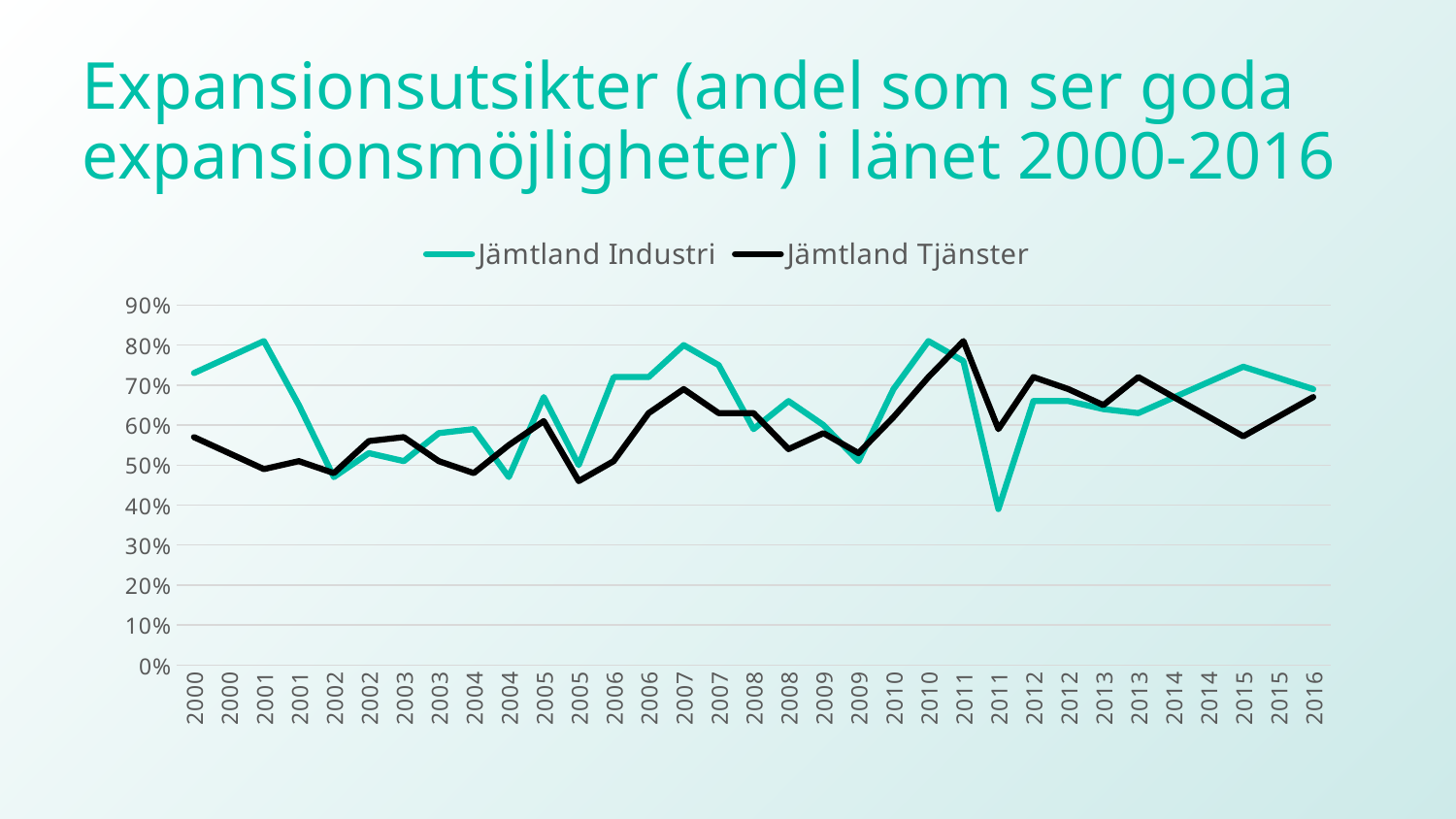
Which two series are listed in the legend? Jämtland Industri and Jämtland Tjänster Is the first 2000 value for Jämtland Industri greater or less than 70%? greater Is the first 2007 value for Jämtland Industri greater or less than 70%? greater What colour is the line for Jämtland Industri? Teal (green) What kind of chart is shown on the slide? Line chart At the second 2011 point, which series has the larger value, Jämtland Industri or Jämtland Tjänster? Jämtland Tjänster How many series does the legend list? 2 Is the second 2011 value for Jämtland Industri greater or less than 50%? less In which year does the Jämtland Industri line reach its lowest point? 2011 At the first 2000 point, which series has the larger value, Jämtland Industri or Jämtland Tjänster? Jämtland Industri